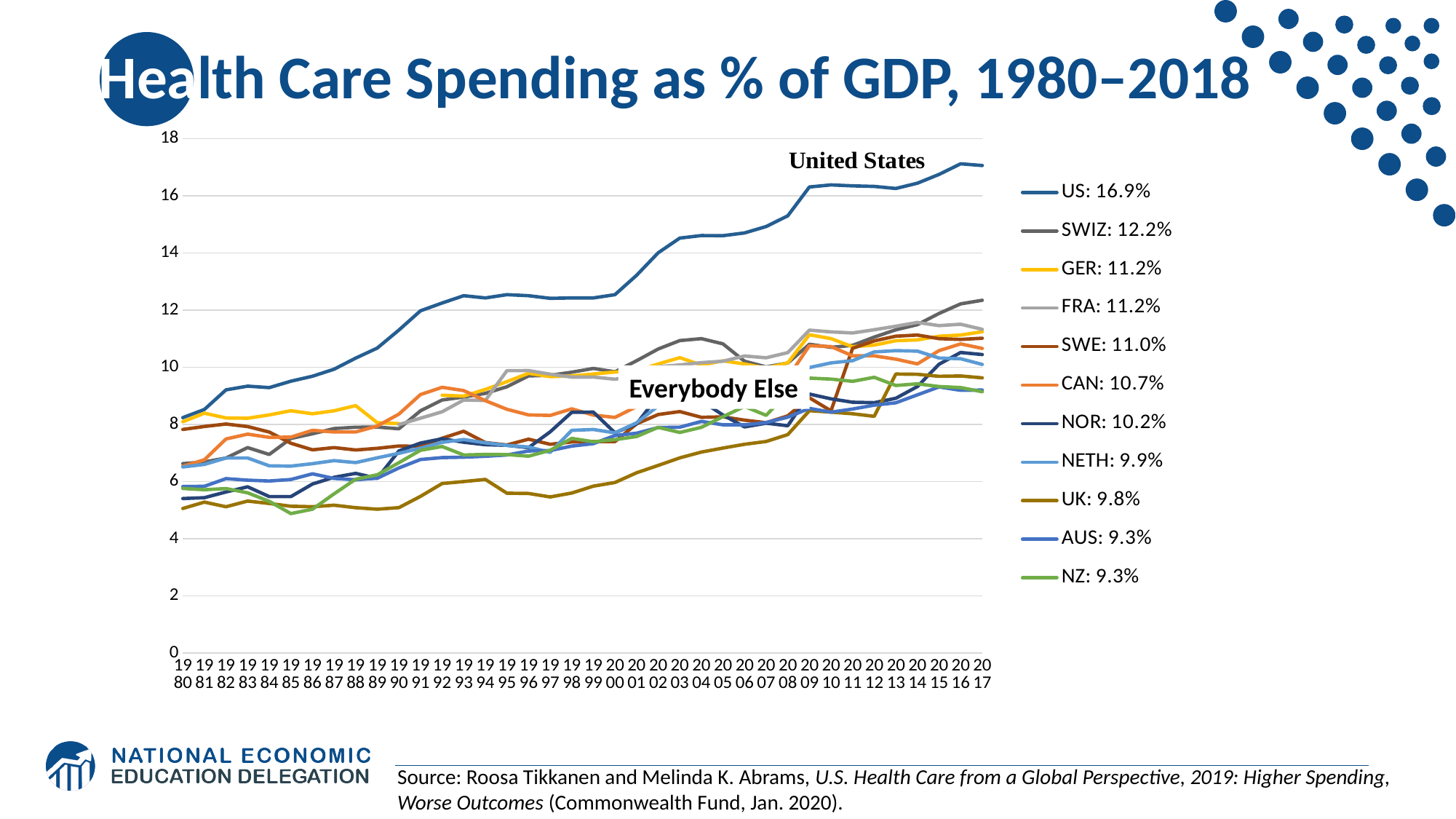
How many series does the legend list? 11 What value does the legend give for CAN? 10.7% Does the United States line rise or fall from 1980 to 2017? rises What value does the legend give for the UK? 9.8% What is the title of the chart? Health Care Spending as % of GDP, 1980–2018 Which has the larger legend value, SWE or CAN? SWE What is the difference between the legend values for the US and SWIZ? 4.7 percentage points What kind of chart is shown on the slide? line chart What value does the legend give for the US? 16.9% What value does the legend give for SWIZ? 12.2% Which country has the highest value in the legend? US Is the value for the United States in 2017 greater or less than 16? greater